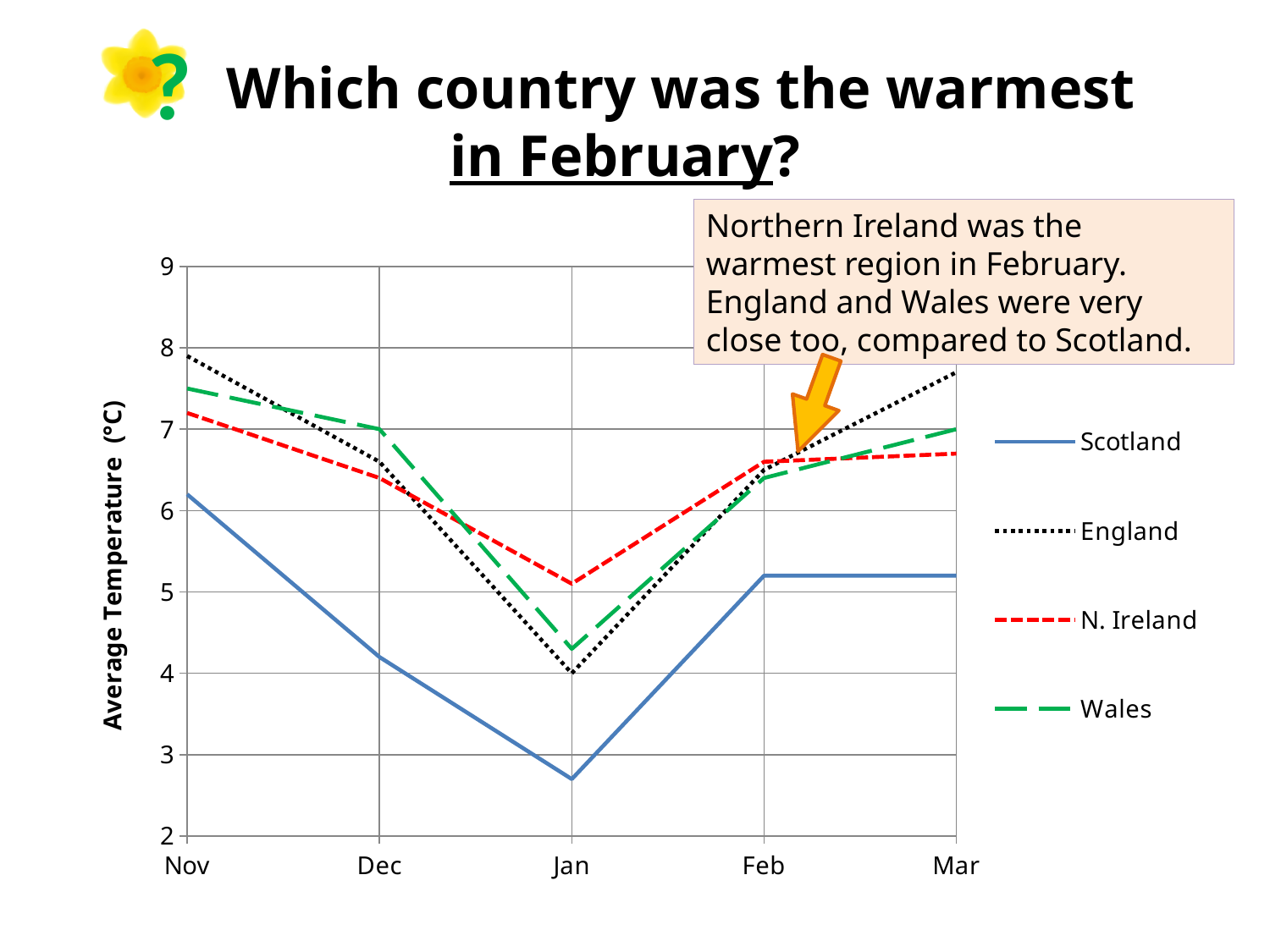
Which country has the highest average temperature in Nov? England Does the Scotland line rise or fall from Nov to Jan? fall Is the value for Scotland in Jan greater or less than 3? less How many series does the legend list? 4 Is the value for England in Nov greater or less than 7? greater Which series is drawn as a solid blue line? Scotland How many months are shown along the x axis? 5 What is the title of the vertical axis? Average Temperature (°C) What kind of chart is shown on the slide? line chart Is the value for Scotland in Feb greater or less than 5? greater Which country has the lowest average temperature in Jan? Scotland Which country has the highest average temperature in Mar? England